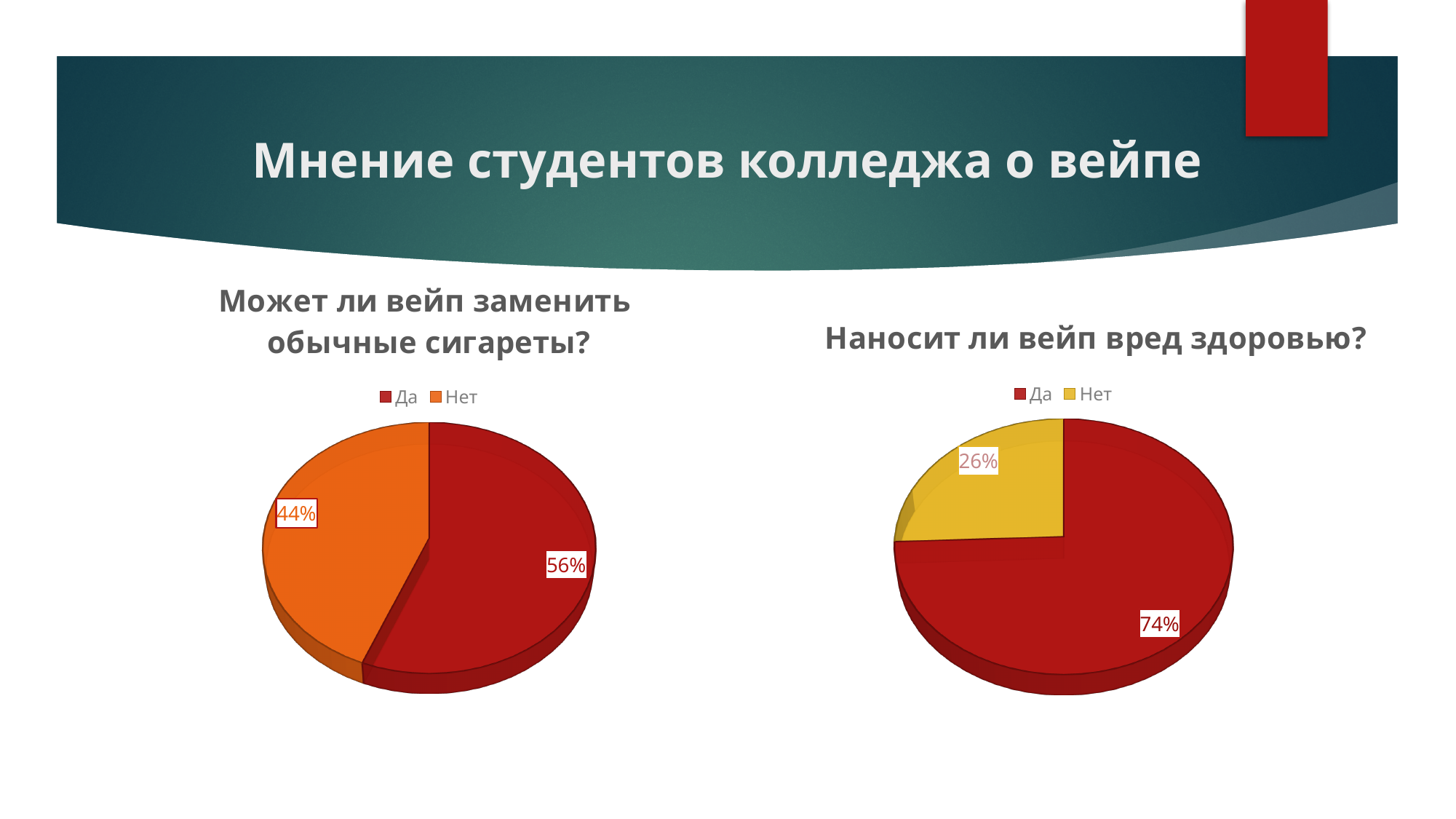
In the right chart 'Наносит ли вейп вред здоровью?', what colour is the 'Нет' slice? Yellow In the right chart 'Наносит ли вейп вред здоровью?', which answer has the smallest slice? Нет In the right chart 'Наносит ли вейп вред здоровью?', what is the difference in percentage points between 'Да' and 'Нет'? 48 In the left chart 'Может ли вейп заменить обычные сигареты?', which answer has the largest slice? Да Which is larger: the 'Да' share in the left chart or the 'Да' share in the right chart? The 'Да' share in the right chart In the right chart 'Наносит ли вейп вред здоровью?', what share of students answered 'Нет'? 26% In the left chart 'Может ли вейп заменить обычные сигареты?', what share of students answered 'Нет'? 44% In the left chart 'Может ли вейп заменить обычные сигареты?', what share of students answered 'Да'? 56% What type of chart is used on the right, 'Наносит ли вейп вред здоровью?'? Pie chart How many categories does the legend of the left chart 'Может ли вейп заменить обычные сигареты?' list? 2 In the right chart 'Наносит ли вейп вред здоровью?', what share of students answered 'Да'? 74% In the left chart 'Может ли вейп заменить обычные сигареты?', what is the difference in percentage points between 'Да' and 'Нет'? 12